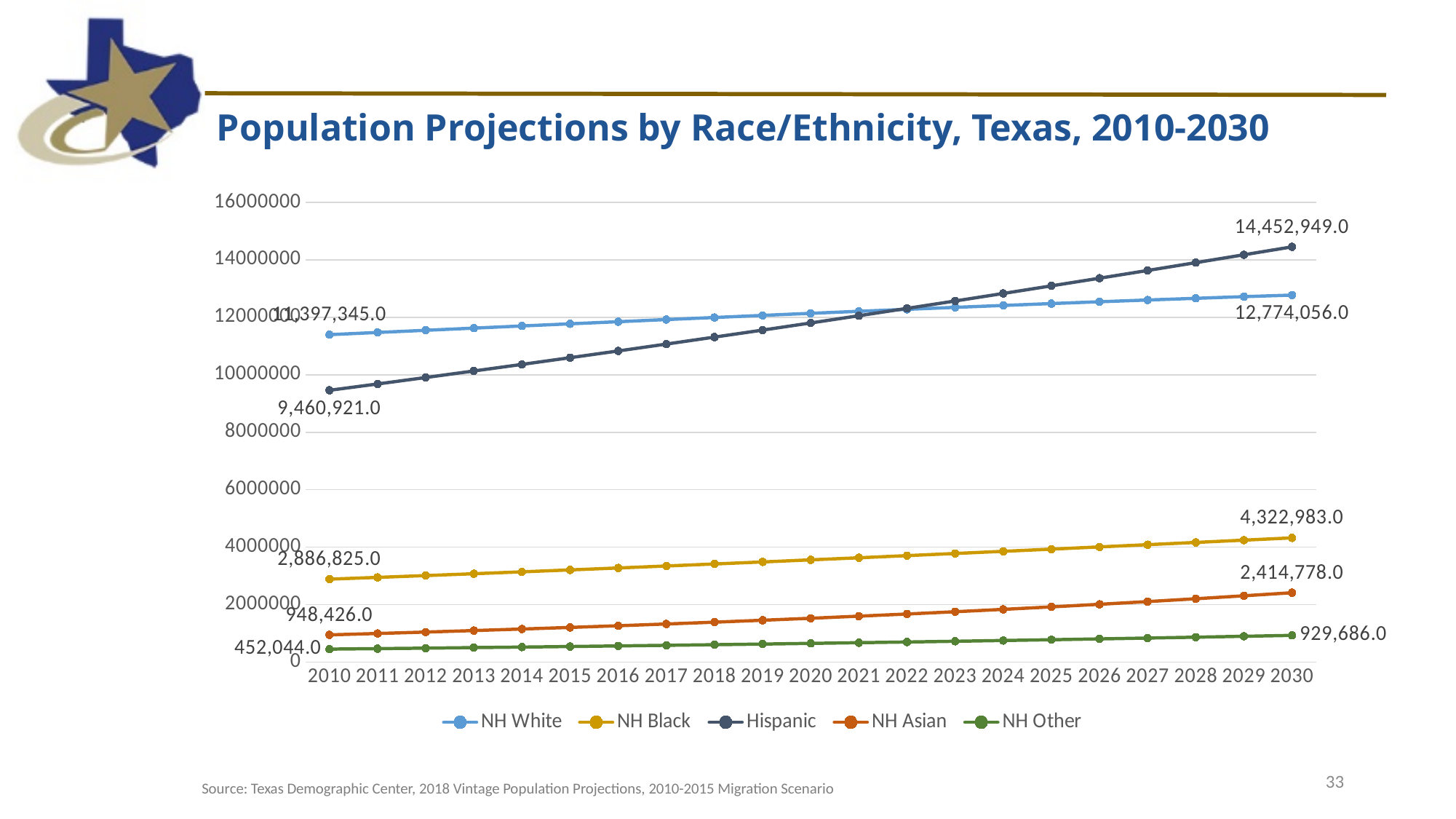
What is the projected NH Black population in 2030? 4,322,983.0 Which race/ethnicity group has the lowest population in 2010? NH Other In 2010, which is larger: the NH White population or the Hispanic population? NH White What is the Hispanic population value shown for 2010? 9,460,921.0 What is the projected Hispanic population in 2030? 14,452,949.0 What is the NH Asian population value shown for 2010? 948,426.0 What kind of chart is shown on the slide? line chart How many series does the legend list? 5 How many years are plotted along the x axis? 21 By how much is the Hispanic population projected to grow from 2010 to 2030? 4,992,028.0 Which race/ethnicity group has the highest projected population in 2030? Hispanic What is the projected NH Other population in 2030? 929,686.0